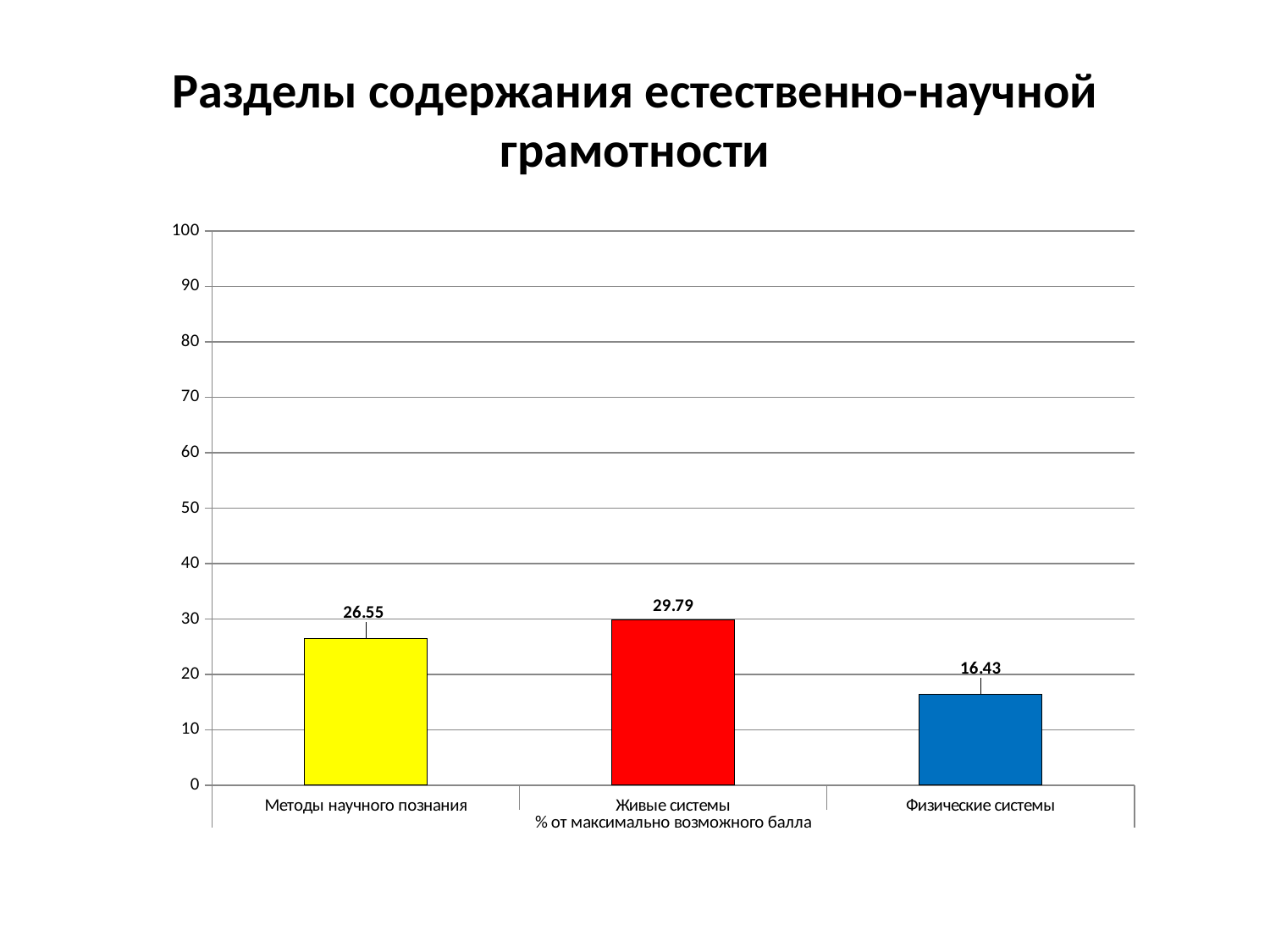
Which category has the lowest value? Физические системы How many categories are shown on the chart? 3 What is the value for Методы научного познания? 26.55 What is the difference between the values for Живые системы and Методы научного познания? 3.24 What kind of chart is shown on the slide? bar chart Which category has the highest value? Живые системы Which is larger, the value for Методы научного познания or the value for Физические системы? Методы научного познания What is the value for Физические системы? 16.43 What is the difference between the values for Живые системы and Физические системы? 13.36 Is the value for Физические системы greater or less than 20? less What is the title of the chart? Разделы содержания естественно-научной грамотности What is the value for Живые системы? 29.79